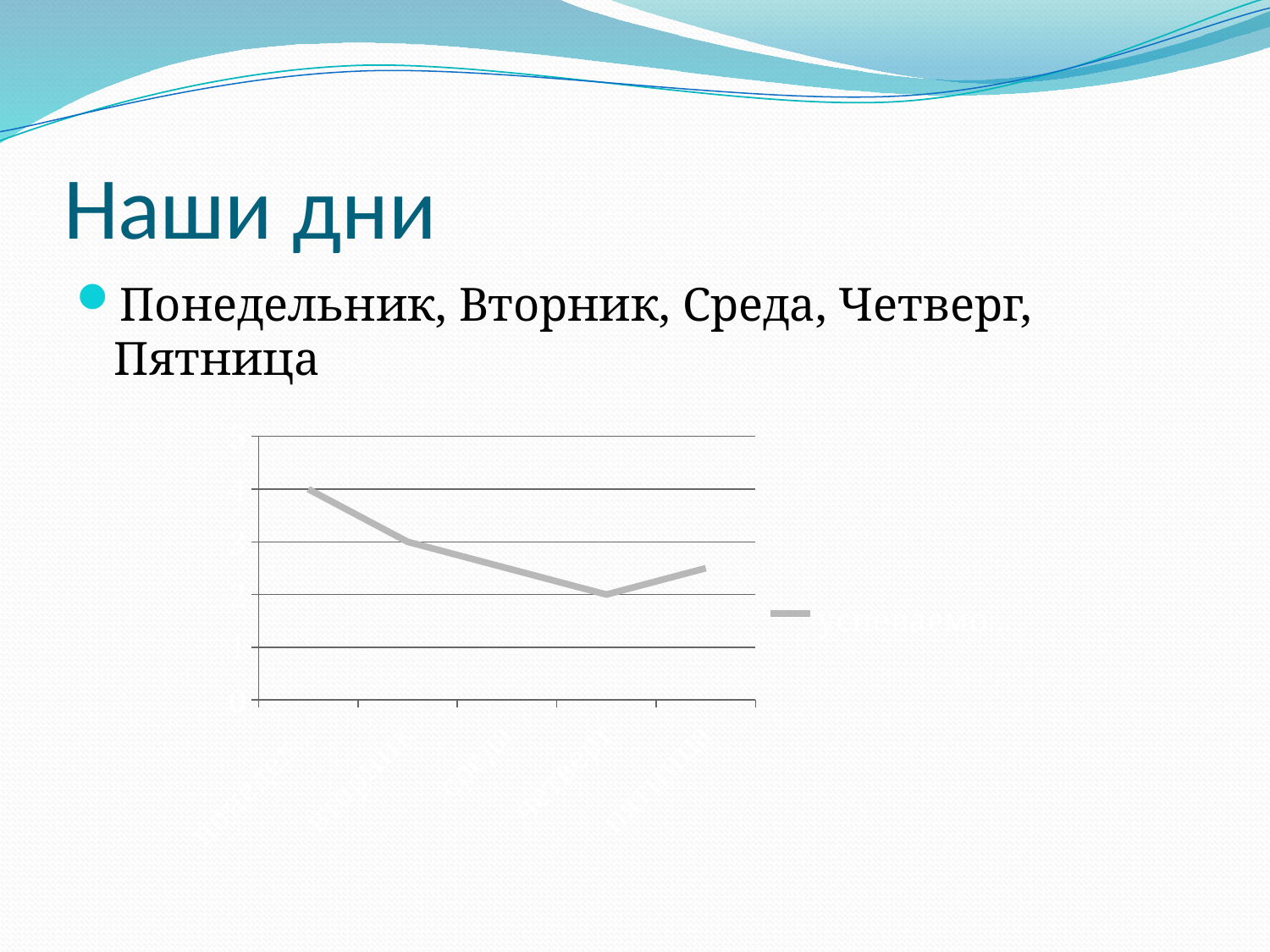
Which is larger, the value at the first point or the value at the last point? the first point Where is the legend positioned relative to the plot area? to the right How many series does the chart's legend list? 1 Which is larger, the value at the second point or the value at the fourth point? the second point Which data point on the line is the lowest? the fourth point How many data points are plotted on the line in the chart? 5 Does the line rise or fall between the fourth and fifth points? rise Does the line rise or fall from the first point to the fourth point? fall What colour is the plotted line in the chart? gray Which data point on the line is the highest? the first point What kind of chart is shown on the slide? line chart